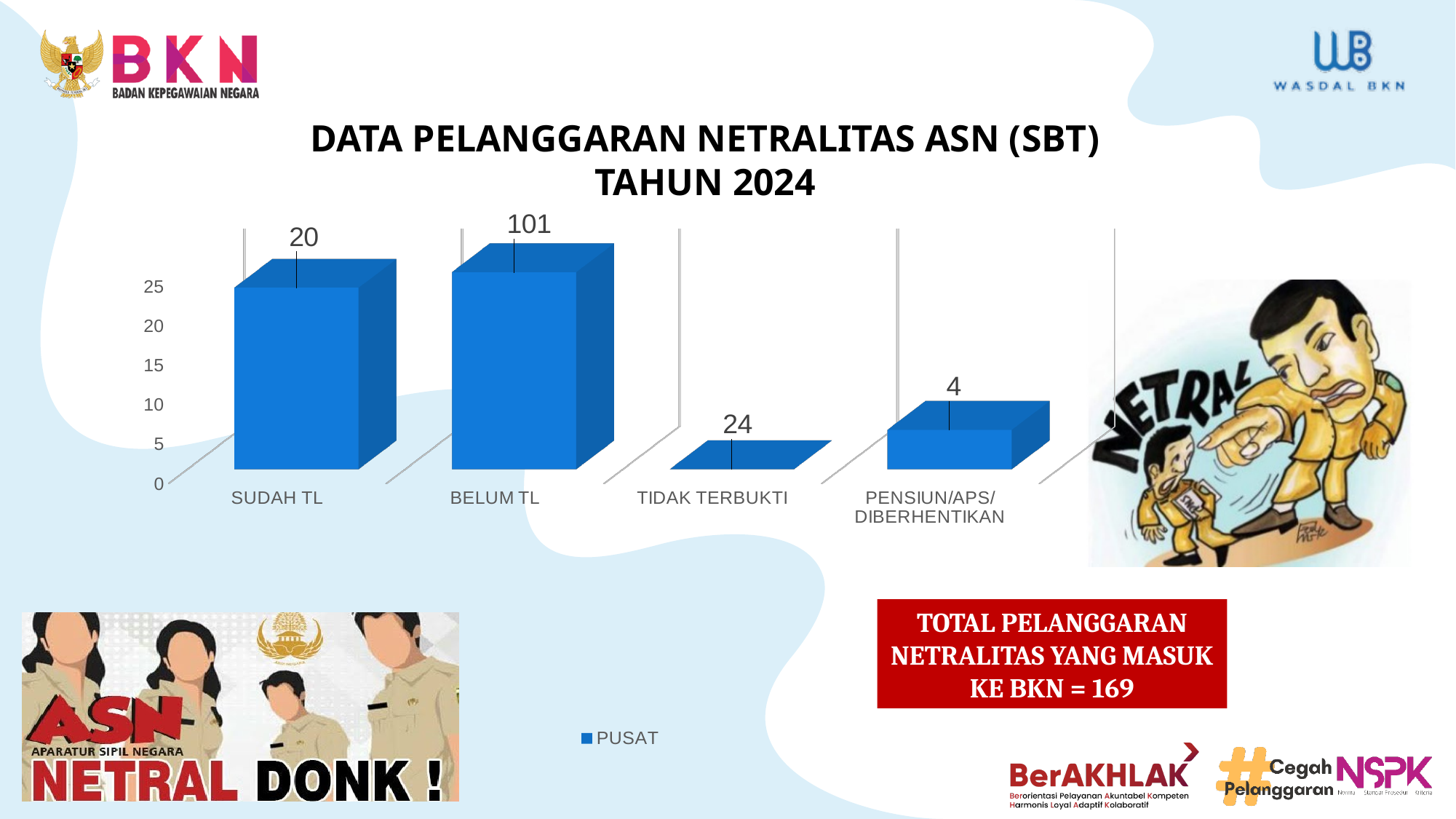
What is the value for PENSIUN/APS/DIBERHENTIKAN? 4 How many categories are shown on the x axis? 4 What series name does the legend show? PUSAT What is the difference between the values for SUDAH TL and PENSIUN/APS/DIBERHENTIKAN? 16 What is the value for BELUM TL? 101 What kind of chart is shown on the slide? Bar chart What is the value for SUDAH TL? 20 Which is larger, the value for BELUM TL or the value for SUDAH TL? BELUM TL What is the value for TIDAK TERBUKTI? 24 What is the difference between the values for BELUM TL and TIDAK TERBUKTI? 77 Which category has the highest value? BELUM TL